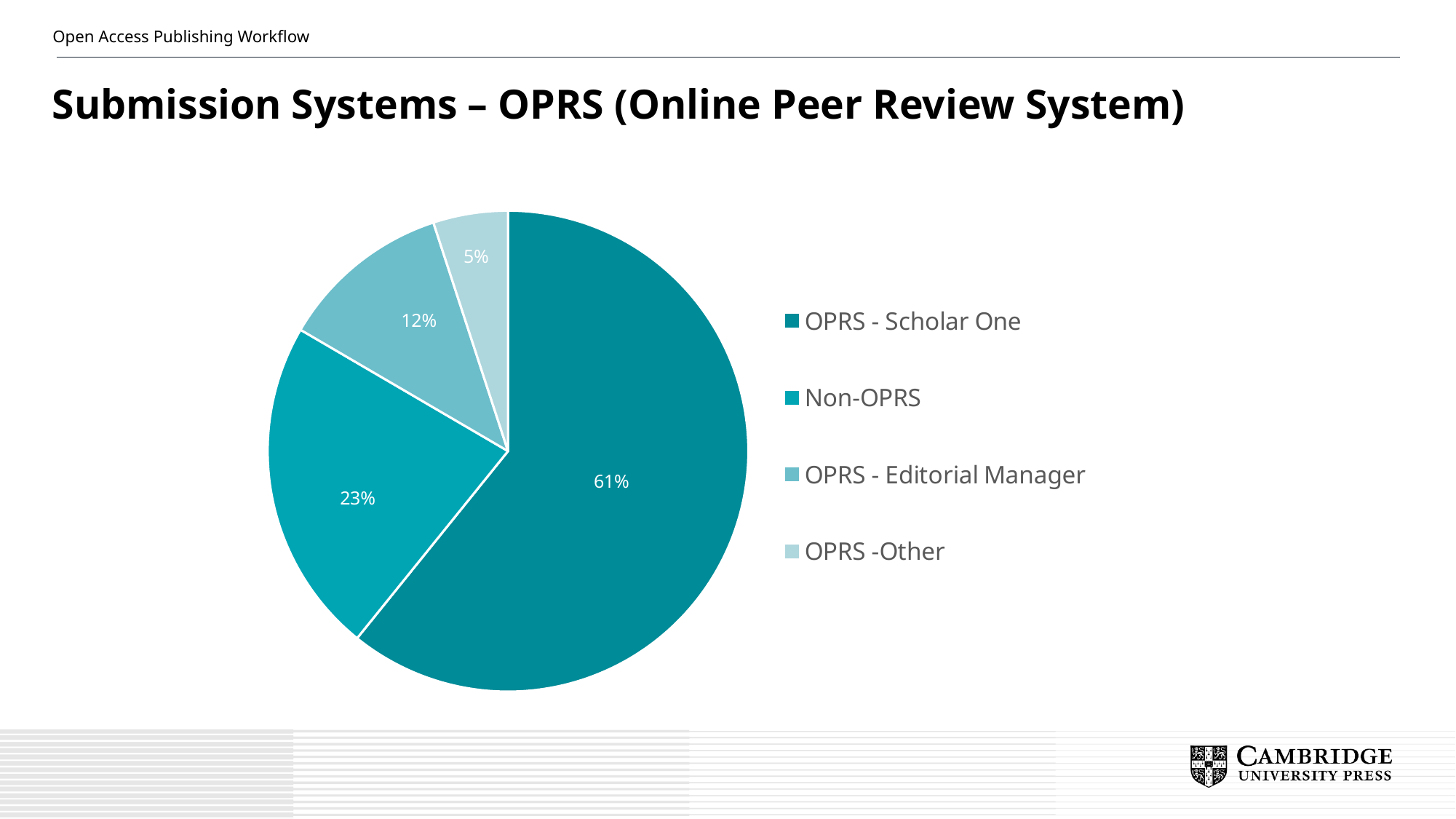
Which category has the smallest slice of the pie? OPRS -Other Which legend entry is shown in the lightest colour? OPRS -Other What is the difference in percentage points between OPRS - Scholar One and Non-OPRS? 38 What share of the pie does OPRS - Scholar One have? 61% What share of the pie does OPRS - Editorial Manager have? 12% Which is larger, the Non-OPRS slice or the OPRS - Editorial Manager slice? Non-OPRS How many categories does the pie chart show? 4 What kind of chart is shown on the slide? pie chart Which category has the largest slice of the pie? OPRS - Scholar One What share of the pie does Non-OPRS have? 23% What is the difference in percentage points between OPRS - Editorial Manager and OPRS -Other? 7